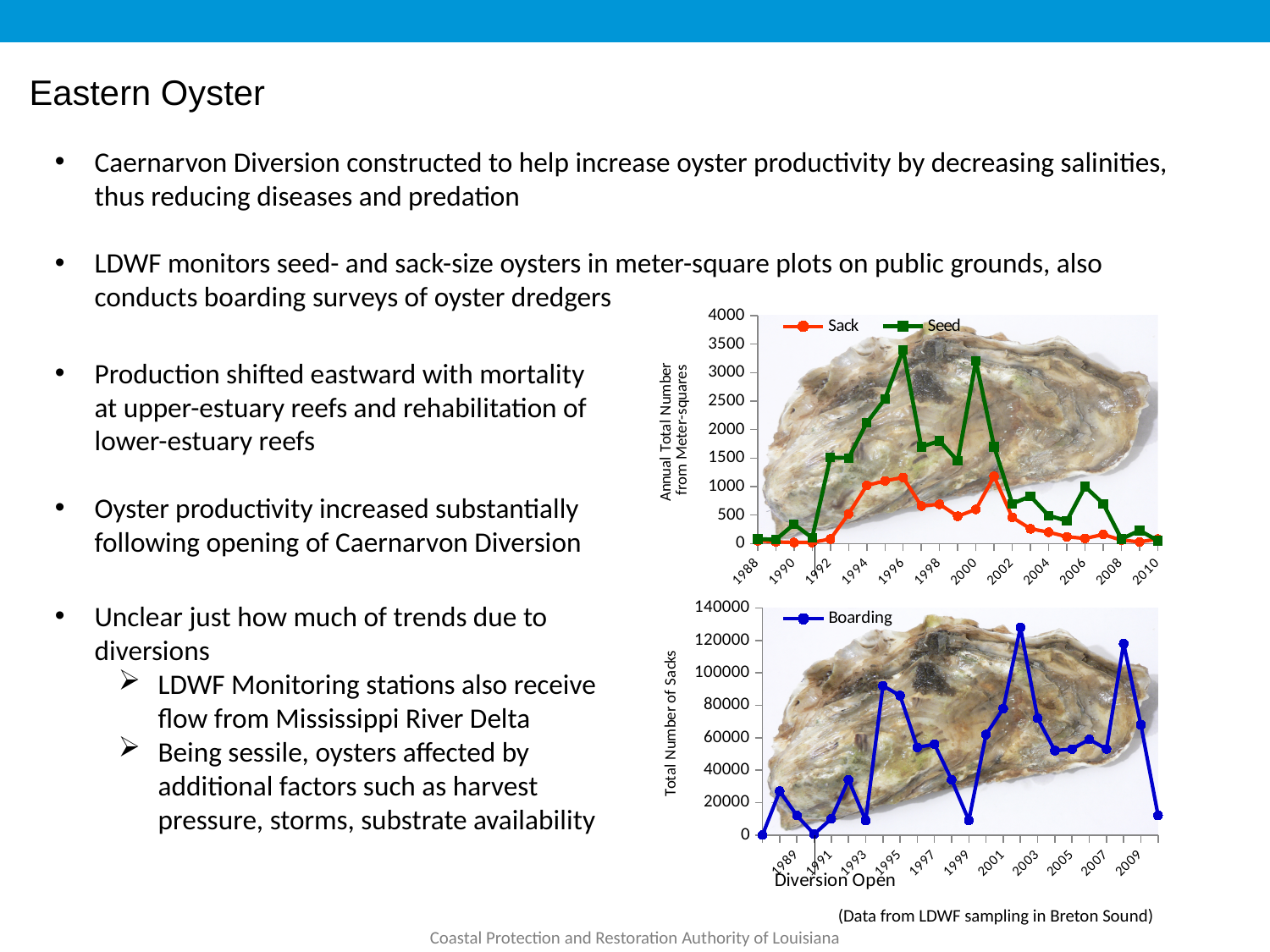
In the top chart, is the Sack value for 1988 greater or less than 500? less In the top chart, is the Sack value for 2001 greater or less than 1000? greater In the bottom Boarding chart, is the value for 1999 greater or less than 20000? less What is the y-axis title of the bottom Boarding chart? Total Number of Sacks In the bottom Boarding chart, which year has the larger value, 1999 or 2002? 2002 What are the two legend entries in the top chart? Sack and Seed What kind of chart is the top chart with the Sack and Seed series? line chart How many series does the legend of the top chart list? 2 In the top chart, which series is larger in 1996, Sack or Seed? Seed